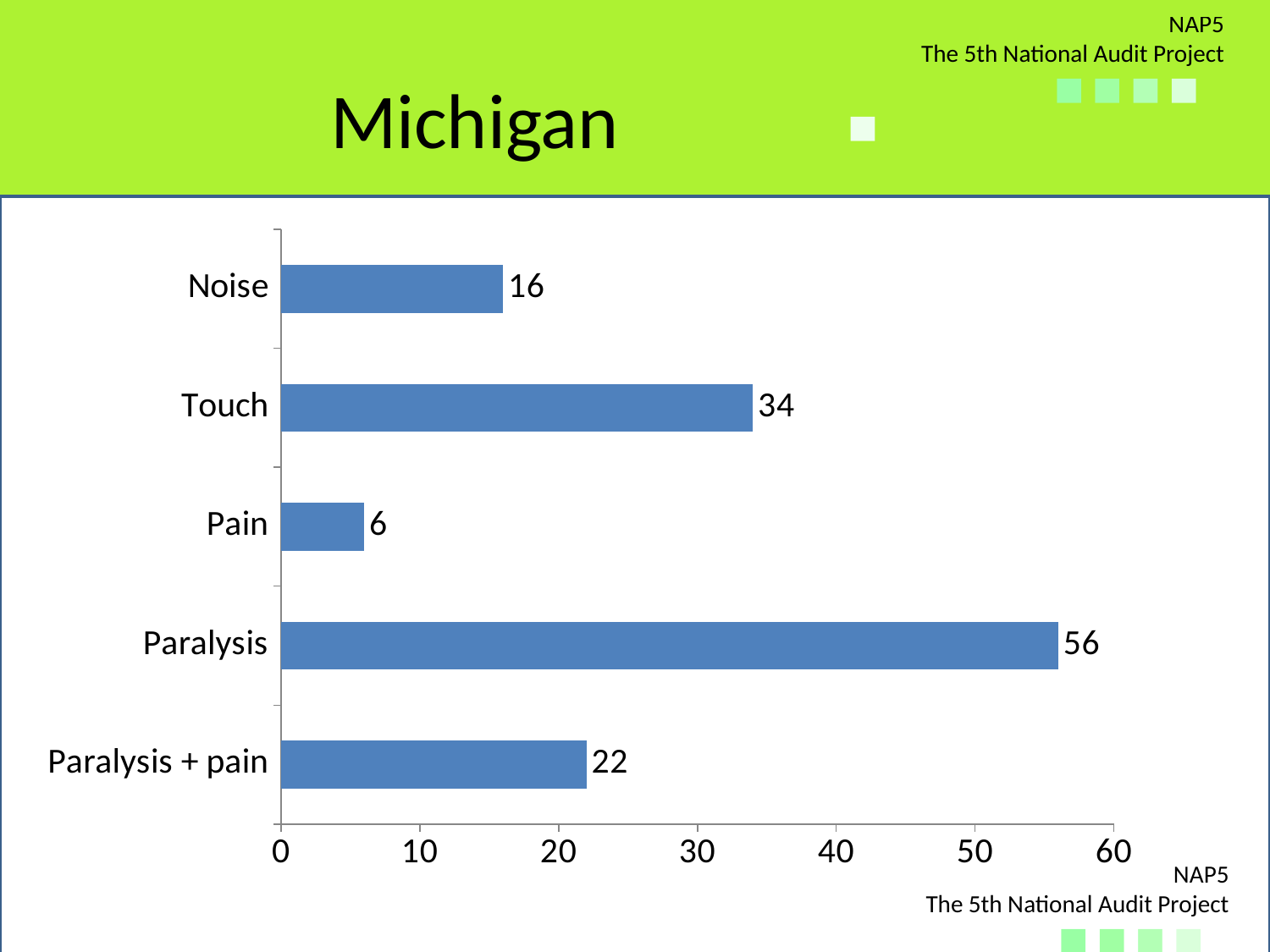
Which is larger, the value for Touch or the value for Noise? Touch What is the title of the slide containing the chart? Michigan What is the value for Touch? 34 What is the value for Paralysis + pain? 22 Which category has the lowest value? Pain What kind of chart is shown on the slide? Bar chart How many categories are shown in the chart? 5 Which category has the highest value? Paralysis What is the value for Paralysis? 56 What is the difference between the values for Paralysis + pain and Pain? 16 What is the value for Noise? 16 What is the difference between the values for Paralysis and Touch? 22